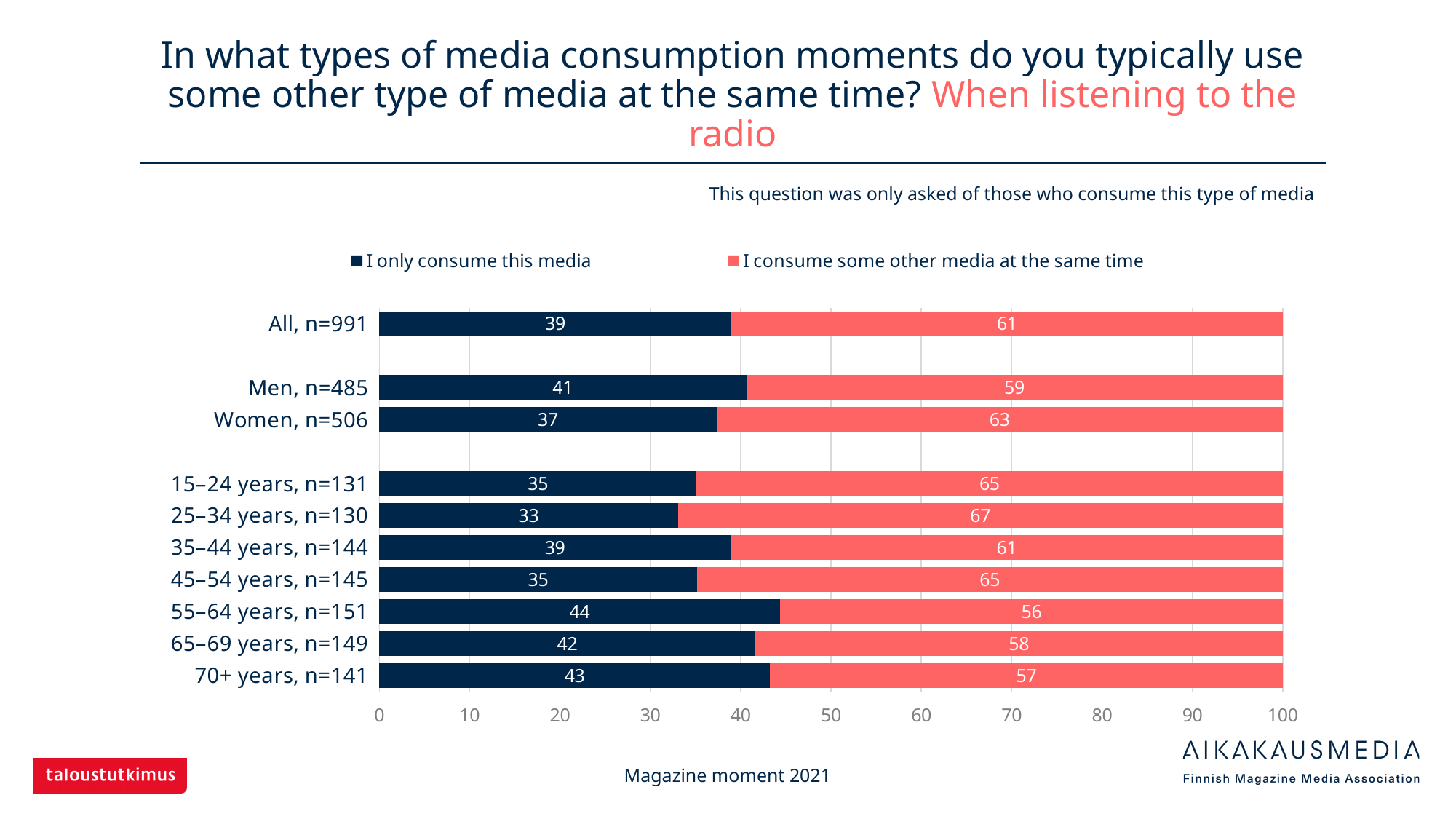
What is the total of the stacked bar for 15–24 years, n=131? 100 Which category has the highest value for "I consume some other media at the same time"? 25–34 years, n=130 What is the value of "I only consume this media" for All, n=991? 39 How many categories are shown on the y axis? 10 Which colour represents "I consume some other media at the same time" in the legend? Red What is the difference between the "I only consume this media" values for Men, n=485 and Women, n=506? 4 Which category has the lowest value for "I only consume this media"? 25–34 years, n=130 How many series does the legend list? 2 What is the value of "I only consume this media" for 55–64 years, n=151? 44 What is the value of "I consume some other media at the same time" for Women, n=506? 63 Which is larger: the "I only consume this media" value for 65–69 years, n=149 or for 70+ years, n=141? 70+ years, n=141 What kind of chart is shown on the slide? Stacked bar chart